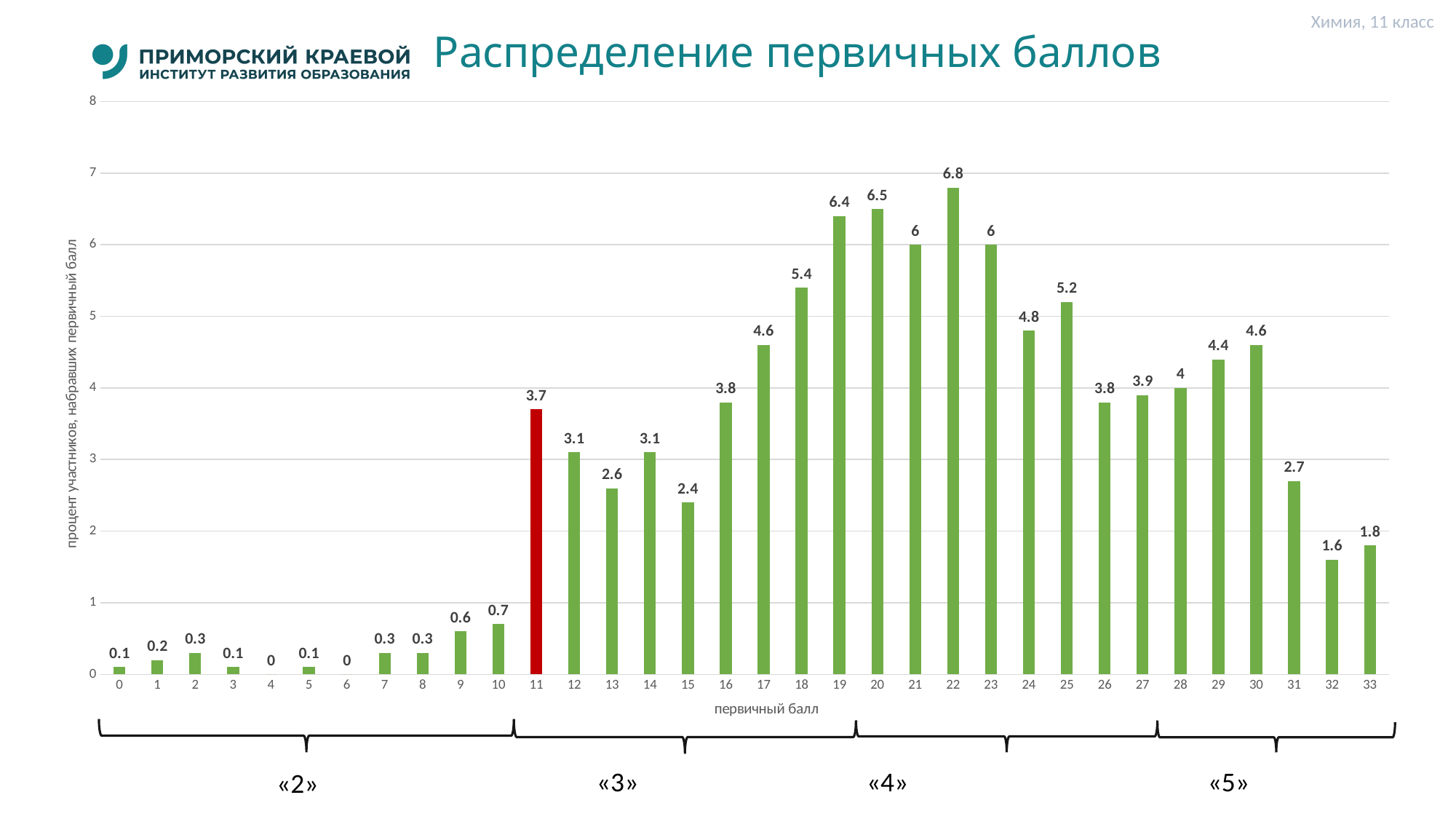
Which bar is coloured red instead of green? 11 Which is larger, the value for primary score 19 or for primary score 25? 19 How many primary score categories are shown on the x axis? 34 What is the value for primary score 33? 1.8 What type of chart is shown on the slide? bar chart Which primary score has the highest percentage of participants? 22 What is the value for primary score 22? 6.8 What is the title of the chart? Распределение первичных баллов What is the value for primary score 11, the red bar? 3.7 What is the value for primary score 18? 5.4 What is the difference between the values for primary scores 22 and 23? 0.8